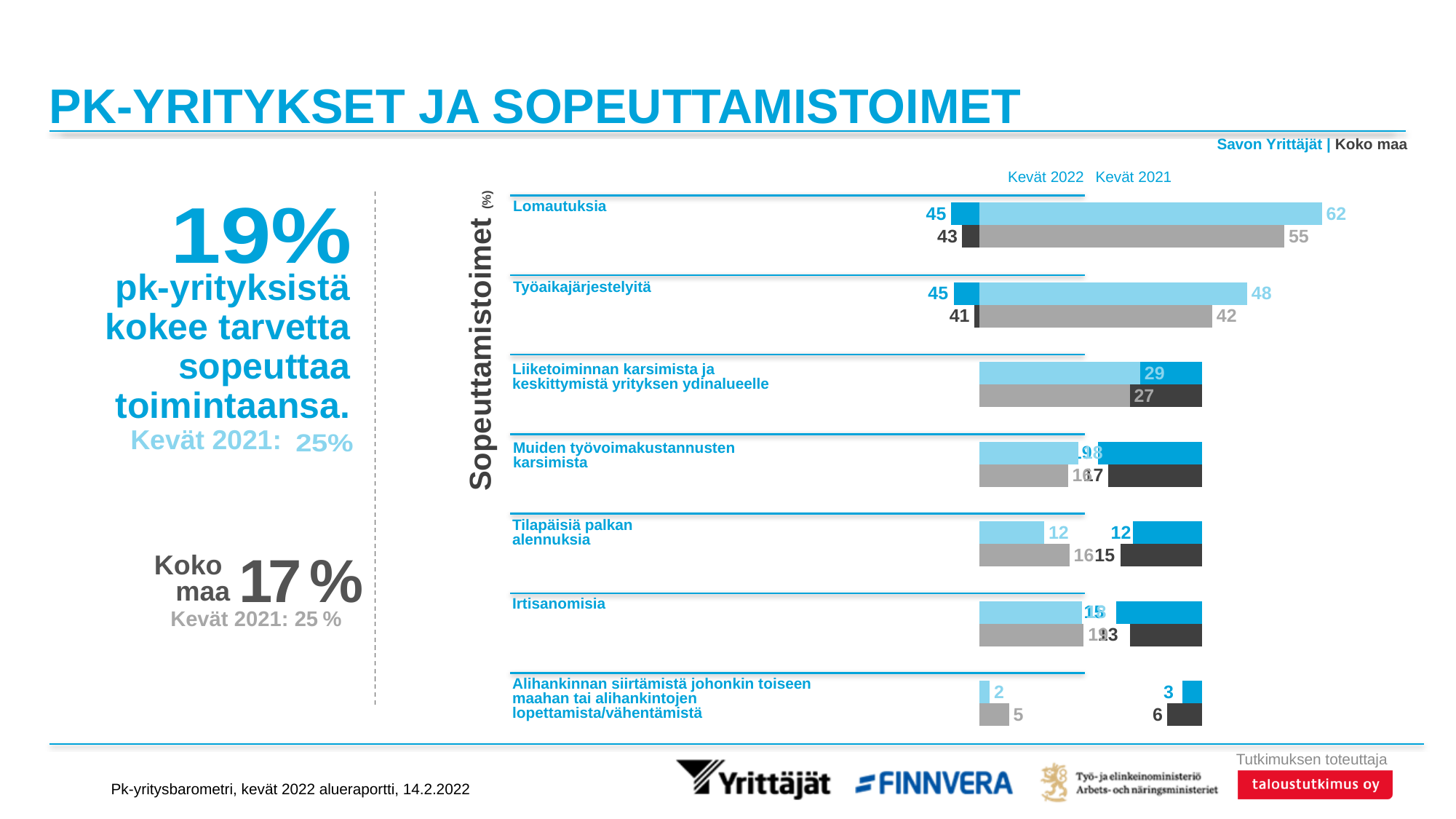
By how much did the Savon Yrittäjät value for Lomautuksia fall from Kevät 2021 to Kevät 2022? 17 Which adjustment measure has the lowest Savon Yrittäjät value in Kevät 2021? Alihankinnan siirtämistä johonkin toiseen maahan tai alihankintojen lopettamista/vähentämistä What is the Savon Yrittäjät value for Lomautuksia in Kevät 2022? 45 What is the Savon Yrittäjät value for Lomautuksia in Kevät 2021? 62 What is the Koko maa value for Työaikajärjestelyitä in Kevät 2022? 41 What is the Koko maa value for Lomautuksia in Kevät 2021? 55 Which adjustment measure has the highest Savon Yrittäjät value in Kevät 2021? Lomautuksia How many series does the legend above the chart list? 2 How many adjustment measures (categories) are listed in the chart? 7 What is the Savon Yrittäjät value for Liiketoiminnan karsimista ja keskittymistä yrityksen ydinalueelle in Kevät 2022? 29 For Työaikajärjestelyitä, which is larger: the Savon Yrittäjät value in Kevät 2021 or in Kevät 2022? Kevät 2021 What kind of chart is shown on the slide? bar chart